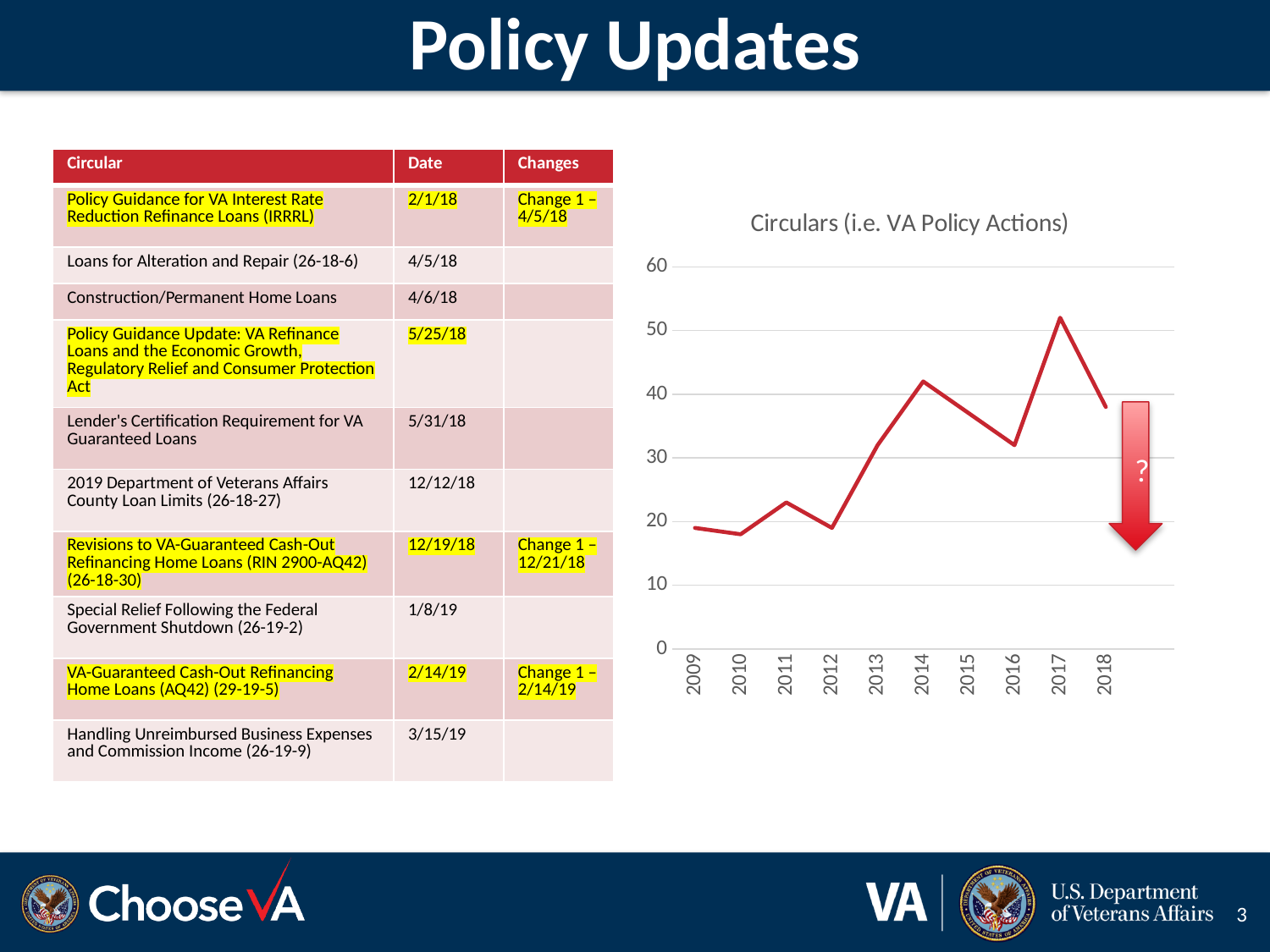
Is the value for 2009 greater or less than 20? less How many years are plotted along the x axis of the chart? 10 Which year has the highest value in the chart? 2017 Which year has the larger value, 2014 or 2016? 2014 What kind of chart is shown on the slide? line chart Which year has the larger value, 2013 or 2011? 2013 Does the line rise or fall between 2017 and 2018? fall Is the value for 2016 greater or less than 30? greater Is the value for 2014 greater or less than 40? greater What is the title of the chart on the slide? Circulars (i.e. VA Policy Actions)